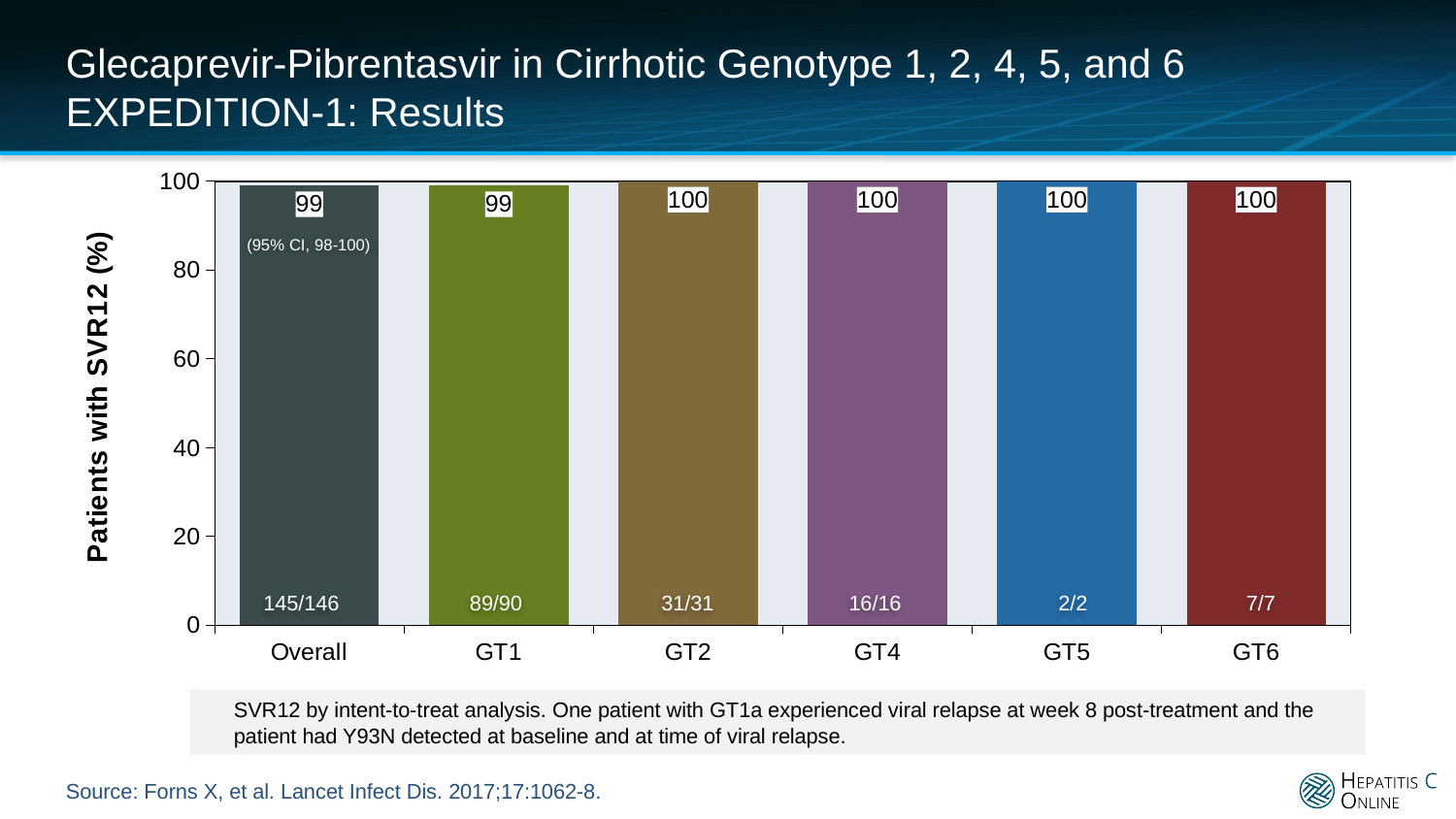
What kind of chart is shown on the slide? Bar chart What is the 95% confidence interval shown for the Overall group? 98-100 What fraction of patients is shown at the base of the Overall bar? 145/146 What is the SVR12 rate for GT1? 99 How many categories are shown on the x axis? 6 Is the SVR12 rate for GT6 greater or less than 80? greater What is the difference between the SVR12 rate for GT4 and the SVR12 rate for GT1? 1 What fraction of patients is shown at the base of the GT5 bar? 2/2 What is the label of the y axis? Patients with SVR12 (%) What is the SVR12 rate for the Overall group? 99 What is the SVR12 rate for GT2? 100 What fraction of patients is shown at the base of the GT1 bar? 89/90